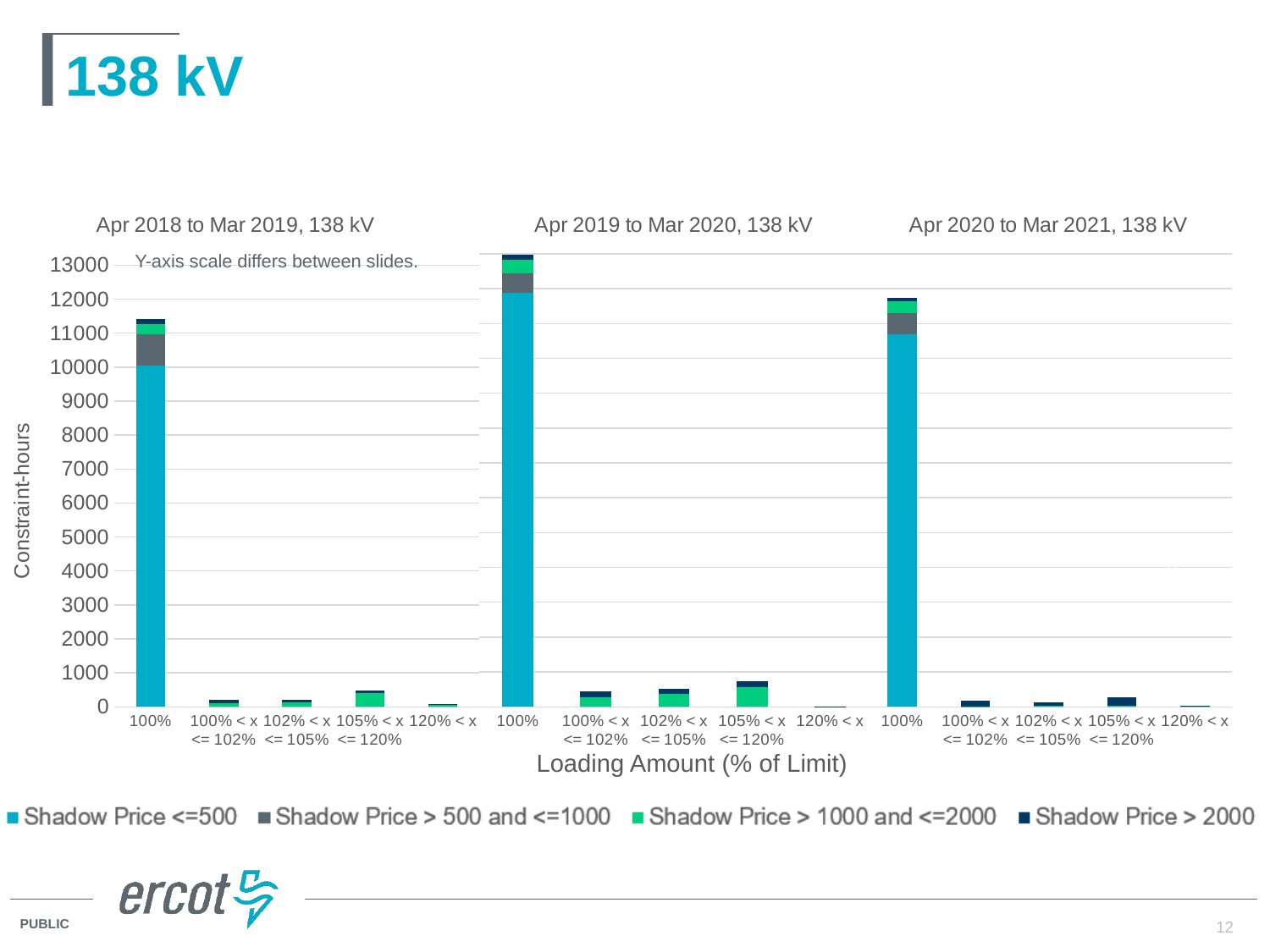
In the Apr 2020 to Mar 2021, 138 kV chart, which loading amount category has the lowest total constraint-hours? 120% < x In the Apr 2018 to Mar 2019, 138 kV chart, is the total value for 100% greater or less than 10000? greater What is the label of the y-axis? Constraint-hours How many series does the legend list? 4 In the Apr 2019 to Mar 2020, 138 kV chart, which loading amount category has the highest total constraint-hours? 100% In the Apr 2018 to Mar 2019, 138 kV chart, how many loading amount categories are shown? 5 In the Apr 2019 to Mar 2020, 138 kV chart, is the total value for 100% greater or less than 12000? greater In the Apr 2020 to Mar 2021, 138 kV chart, is the total value for 100% greater or less than 11000? greater In the Apr 2019 to Mar 2020, 138 kV chart, which is larger: the total for 100% < x <= 102% or the total for 105% < x <= 120%? 105% < x <= 120% What kind of chart is shown on the slide? bar chart Which has the larger total for the 100% category: the Apr 2018 to Mar 2019, 138 kV chart or the Apr 2019 to Mar 2020, 138 kV chart? Apr 2019 to Mar 2020, 138 kV